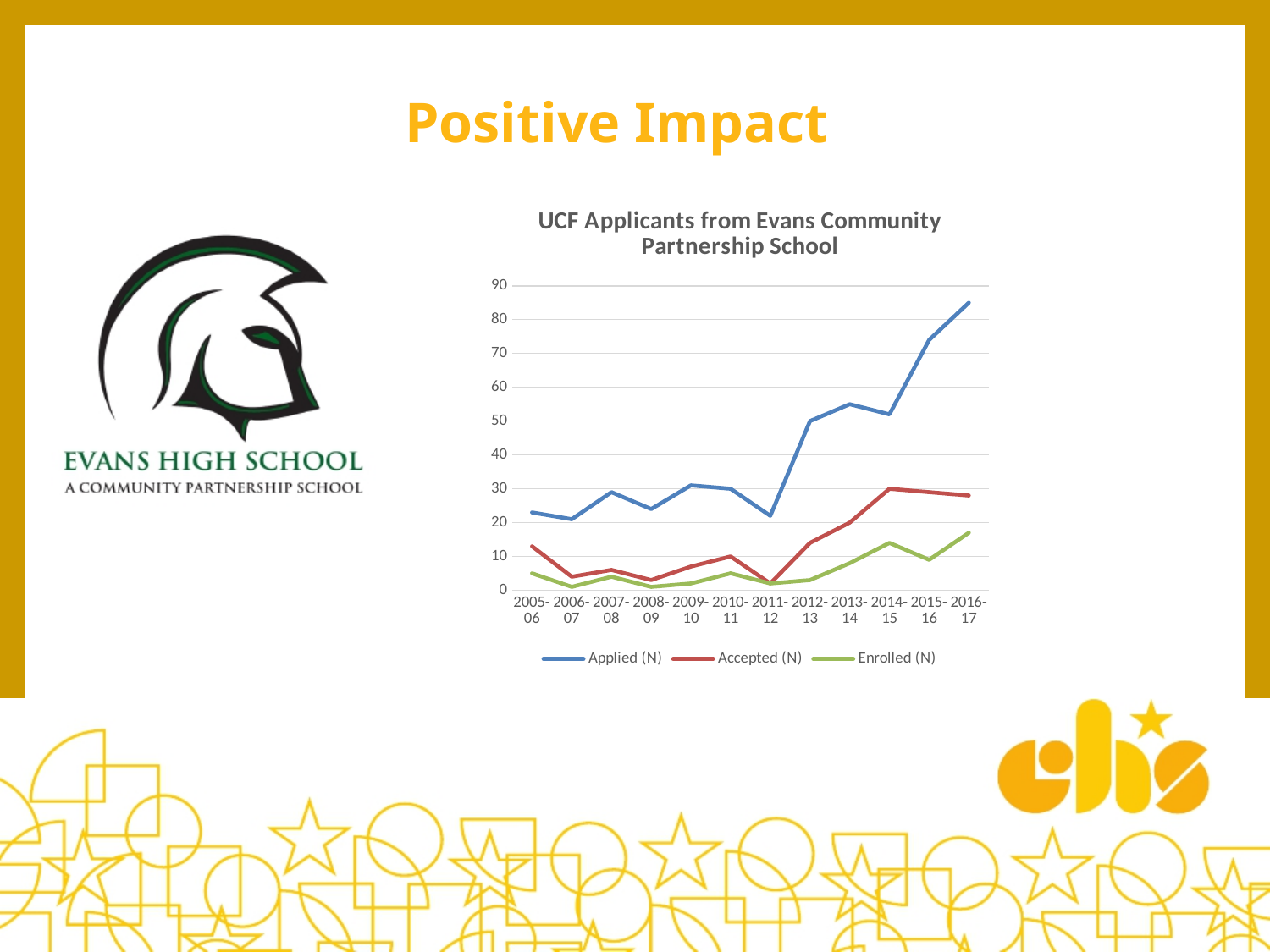
Is the Applied (N) value for 2011-12 greater or less than 30? less Which is larger, the Applied (N) value for 2012-13 or for 2011-12? 2012-13 What is the title of the chart? UCF Applicants from Evans Community Partnership School How many series does the legend of the chart list? 3 Is the Applied (N) value for 2016-17 greater or less than 80? greater In which school year is the Applied (N) value highest? 2016-17 In which school year is the Enrolled (N) value highest? 2016-17 Does the Applied (N) line rise or fall from 2011-12 to 2016-17? rise Which series is drawn in green in the chart? Enrolled (N) How many school years are shown on the x axis of the chart? 12 Is the Accepted (N) value for 2016-17 greater or less than 20? greater What kind of chart is shown on the slide? line chart